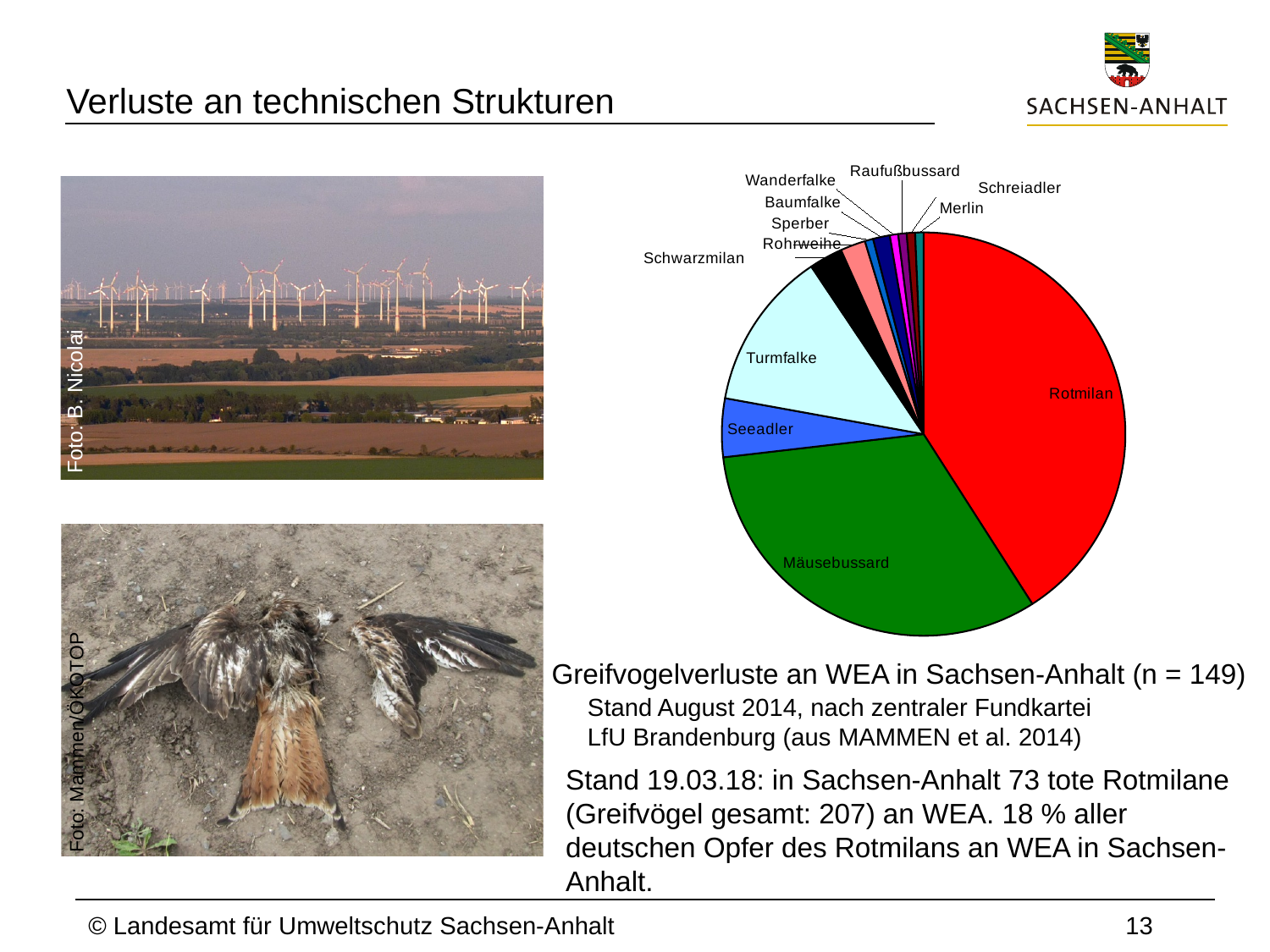
Which slice is larger in the pie chart, Seeadler or Schwarzmilan? Seeadler Which slice is larger in the pie chart, Mäusebussard or Turmfalke? Mäusebussard Which species has the largest slice in the pie chart? Rotmilan What colour is the Mäusebussard slice in the pie chart? green Which slice is larger in the pie chart, Turmfalke or Seeadler? Turmfalke What is the sample size (n) given in the caption below the pie chart? 149 Which species has the second-largest slice in the pie chart? Mäusebussard How many species (slices) are labelled in the pie chart? 12 What kind of chart is shown on the slide? pie chart